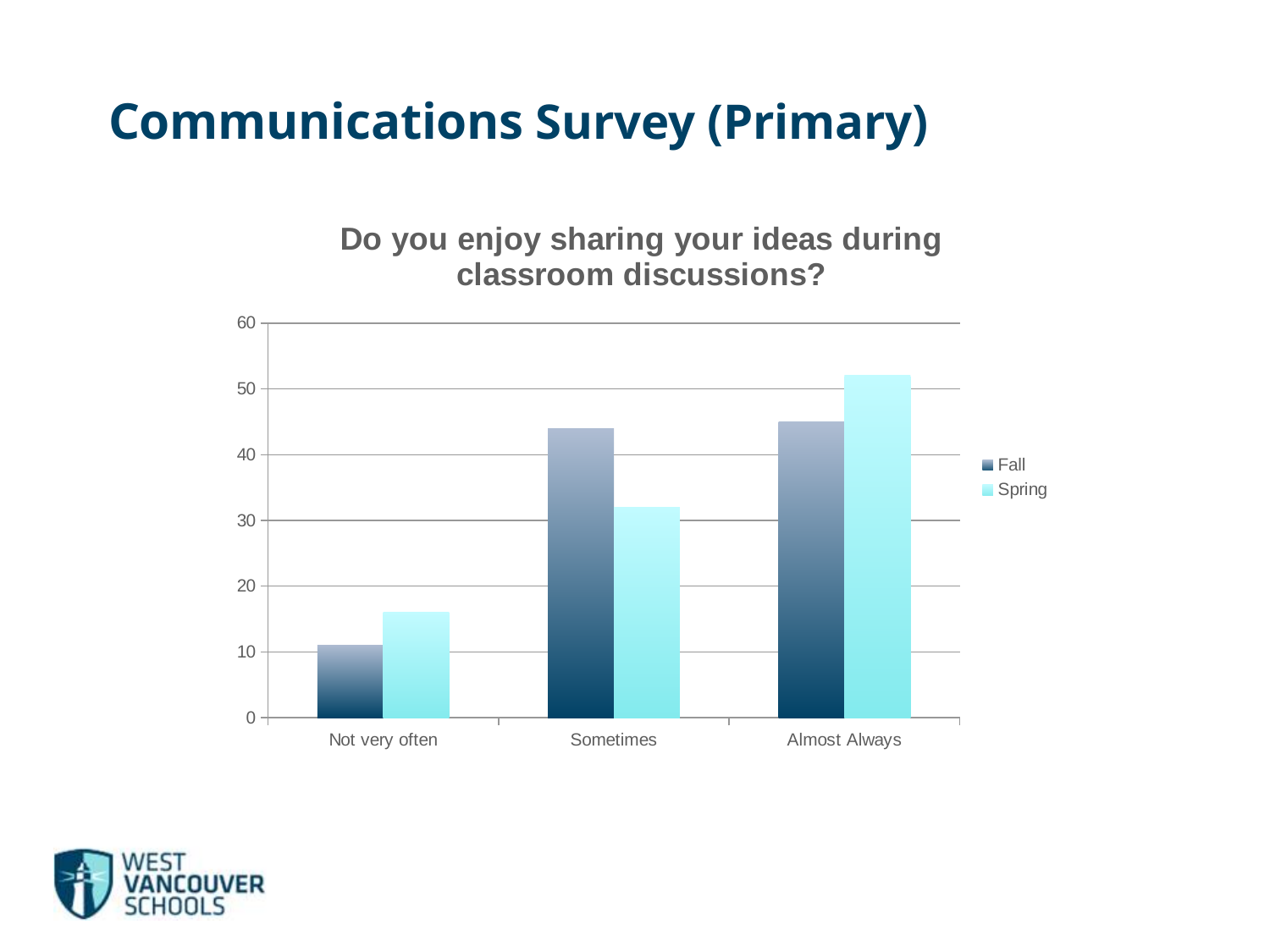
Is the Fall value for Sometimes greater or less than 40? greater How many series does the legend list? 2 For the Almost Always category, which series has the larger value, Fall or Spring? Spring What kind of chart is shown on the slide? bar chart Is the Spring value for Not very often greater or less than 20? less Is the Fall value for Not very often greater or less than 20? less For the Sometimes category, which series has the larger value, Fall or Spring? Fall Which series does the light cyan bar represent? Spring Which category has the highest Spring value? Almost Always What is the title of the chart? Do you enjoy sharing your ideas during classroom discussions? How many categories are shown on the x axis? 3